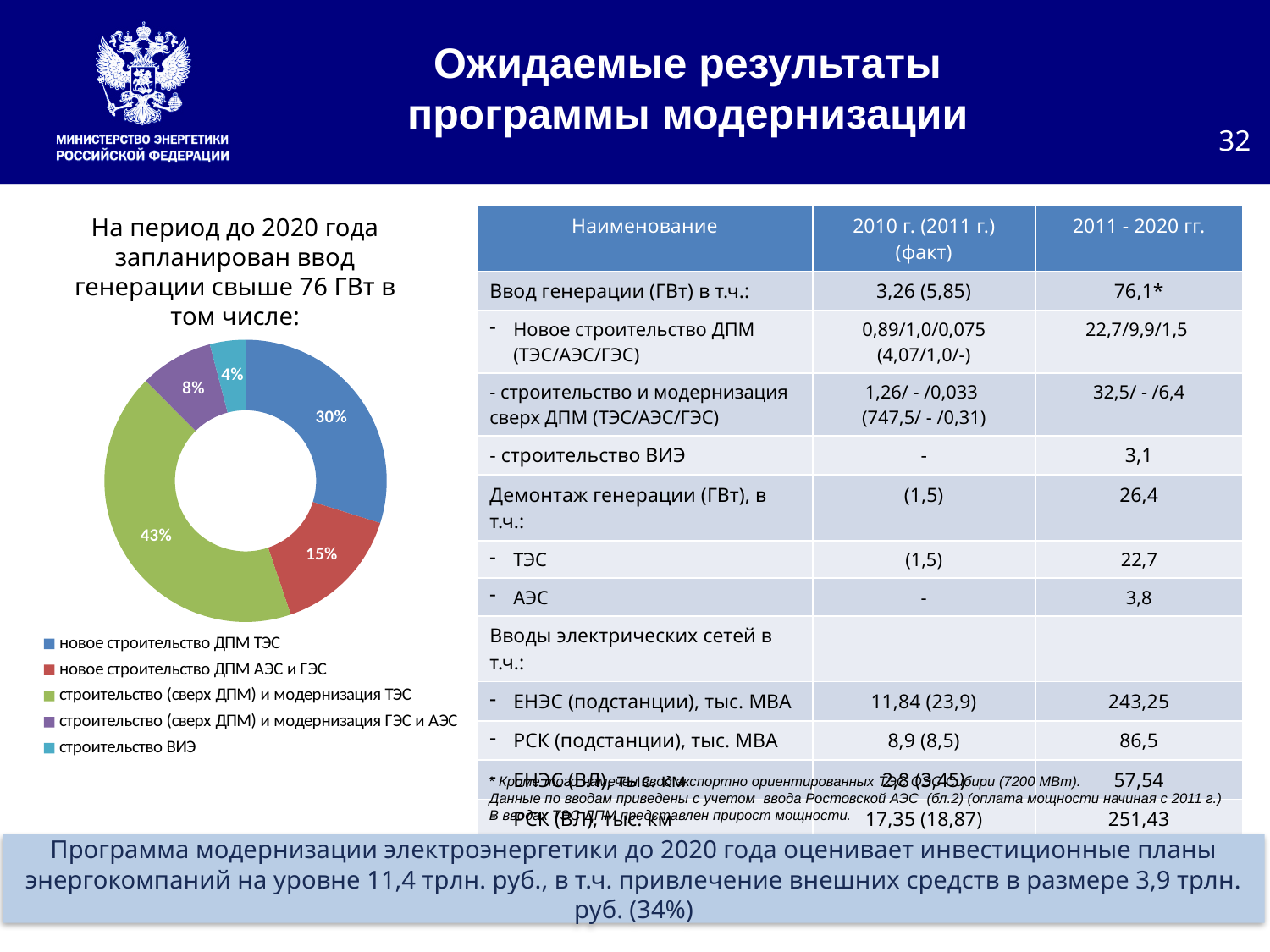
In the doughnut chart, what is the difference in percentage points between 'строительство (сверх ДПМ) и модернизация ТЭС' and 'новое строительство ДПМ ТЭС'? 13 percentage points What share of the doughnut chart is 'строительство (сверх ДПМ) и модернизация ТЭС'? 43% How many entries does the legend of the doughnut chart list? 5 What share of the doughnut chart is 'строительство ВИЭ'? 4% What colour is the slice for 'строительство (сверх ДПМ) и модернизация ТЭС' in the doughnut chart? Green How many slices does the doughnut chart have? 5 In the doughnut chart, which is larger: 'новое строительство ДПМ АЭС и ГЭС' or 'строительство (сверх ДПМ) и модернизация ГЭС и АЭС'? новое строительство ДПМ АЭС и ГЭС What type of chart is shown on the left of the slide? Doughnut (pie) chart Which category has the smallest share in the doughnut chart? строительство ВИЭ What share of the doughnut chart is 'новое строительство ДПМ АЭС и ГЭС'? 15% Which category has the largest share in the doughnut chart? строительство (сверх ДПМ) и модернизация ТЭС